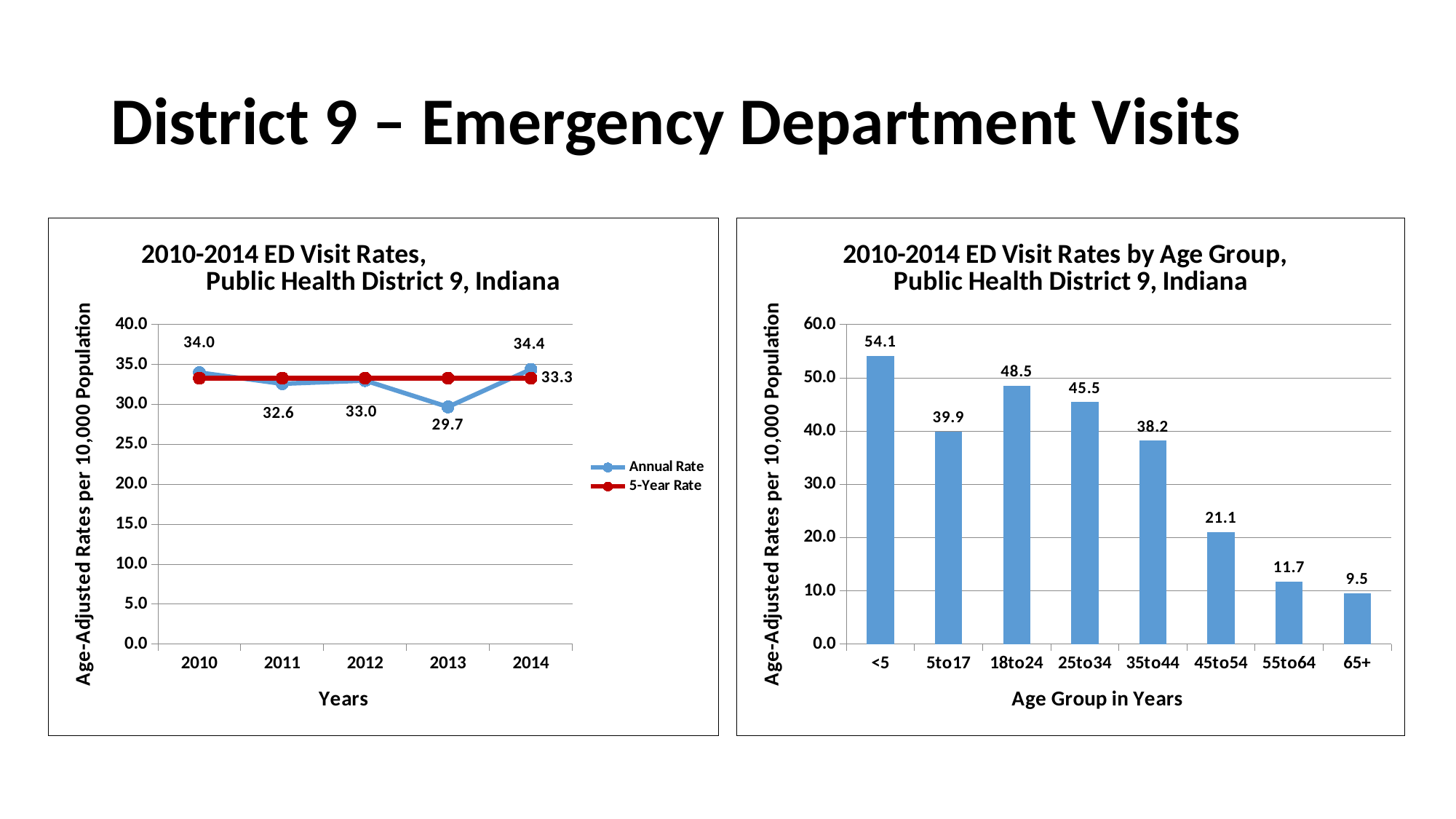
In the right chart (ED Visit Rates by Age Group), how many age groups are shown? 8 In the right chart (ED Visit Rates by Age Group), what is the rate for the 25to34 age group? 45.5 In the right chart (ED Visit Rates by Age Group), which age group has the lowest rate? 65+ In the left chart (2010-2014 ED Visit Rates), what is the 5-Year Rate? 33.3 In the left chart (2010-2014 ED Visit Rates), what is the Annual Rate for 2013? 29.7 In the left chart (2010-2014 ED Visit Rates), what kind of chart is it? Line chart In the left chart (2010-2014 ED Visit Rates), which year has the lowest Annual Rate? 2013 In the right chart (ED Visit Rates by Age Group), is the rate for 18to24 larger or smaller than the rate for 5to17? larger In the left chart (2010-2014 ED Visit Rates), which year has the highest Annual Rate? 2014 In the right chart (ED Visit Rates by Age Group), which age group has the highest rate? <5 In the left chart (2010-2014 ED Visit Rates), what is the difference between the Annual Rate in 2014 and in 2013? 4.7 In the left chart (2010-2014 ED Visit Rates), how many series does the legend list? 2